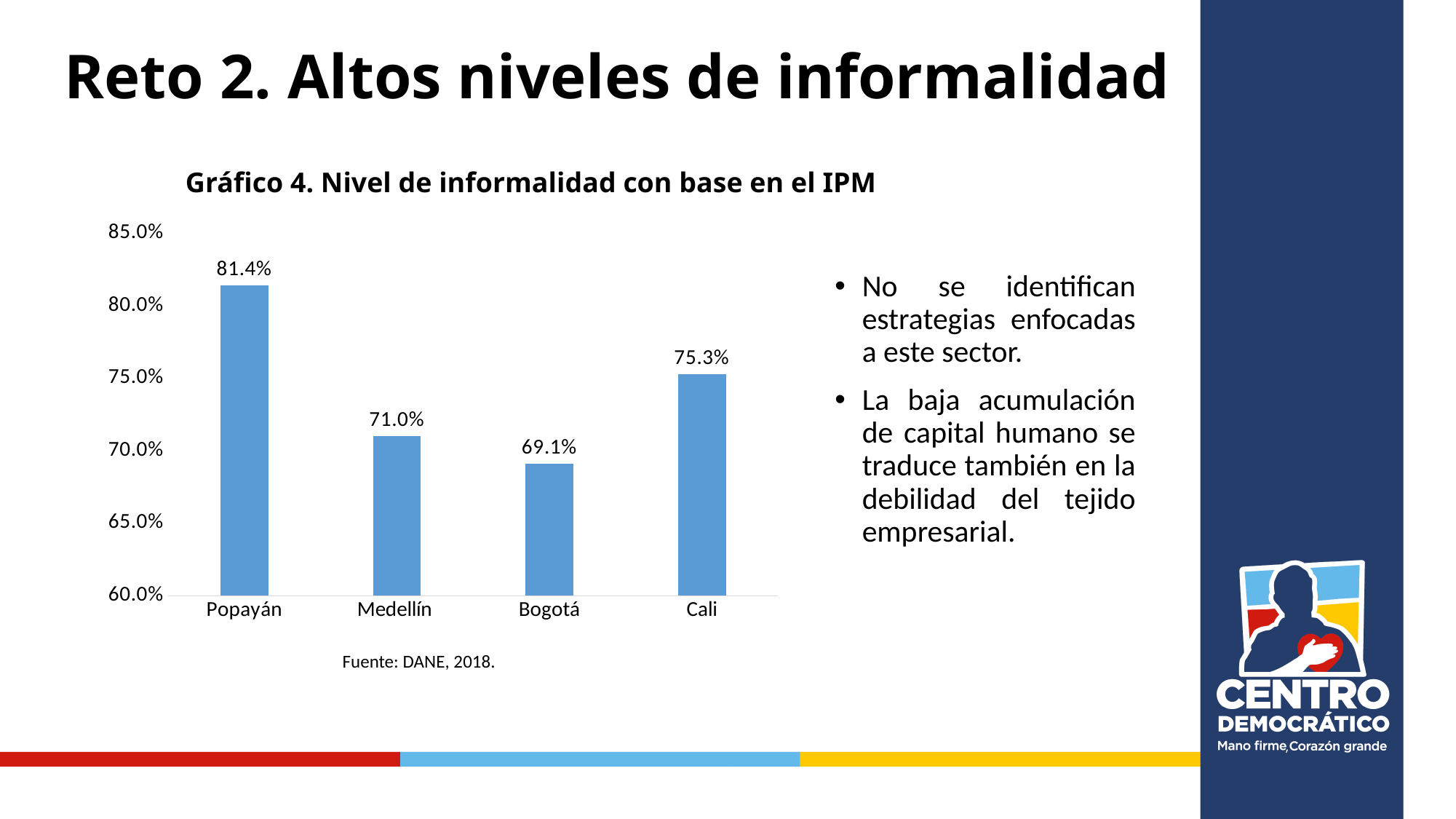
What is the title of the chart? Gráfico 4. Nivel de informalidad con base en el IPM What kind of chart is shown on the slide? Bar chart Is the value for Cali greater or less than 80.0%? less What is the informality level for Cali? 75.3% How many cities are shown in the chart? 4 Which city has the highest informality level? Popayán What is the informality level for Medellín? 71.0% What is the informality level for Popayán? 81.4% Which has a higher informality level, Cali or Medellín? Cali Which city has the lowest informality level? Bogotá What is the difference in informality level between Popayán and Bogotá? 12.3% What is the informality level for Bogotá? 69.1%